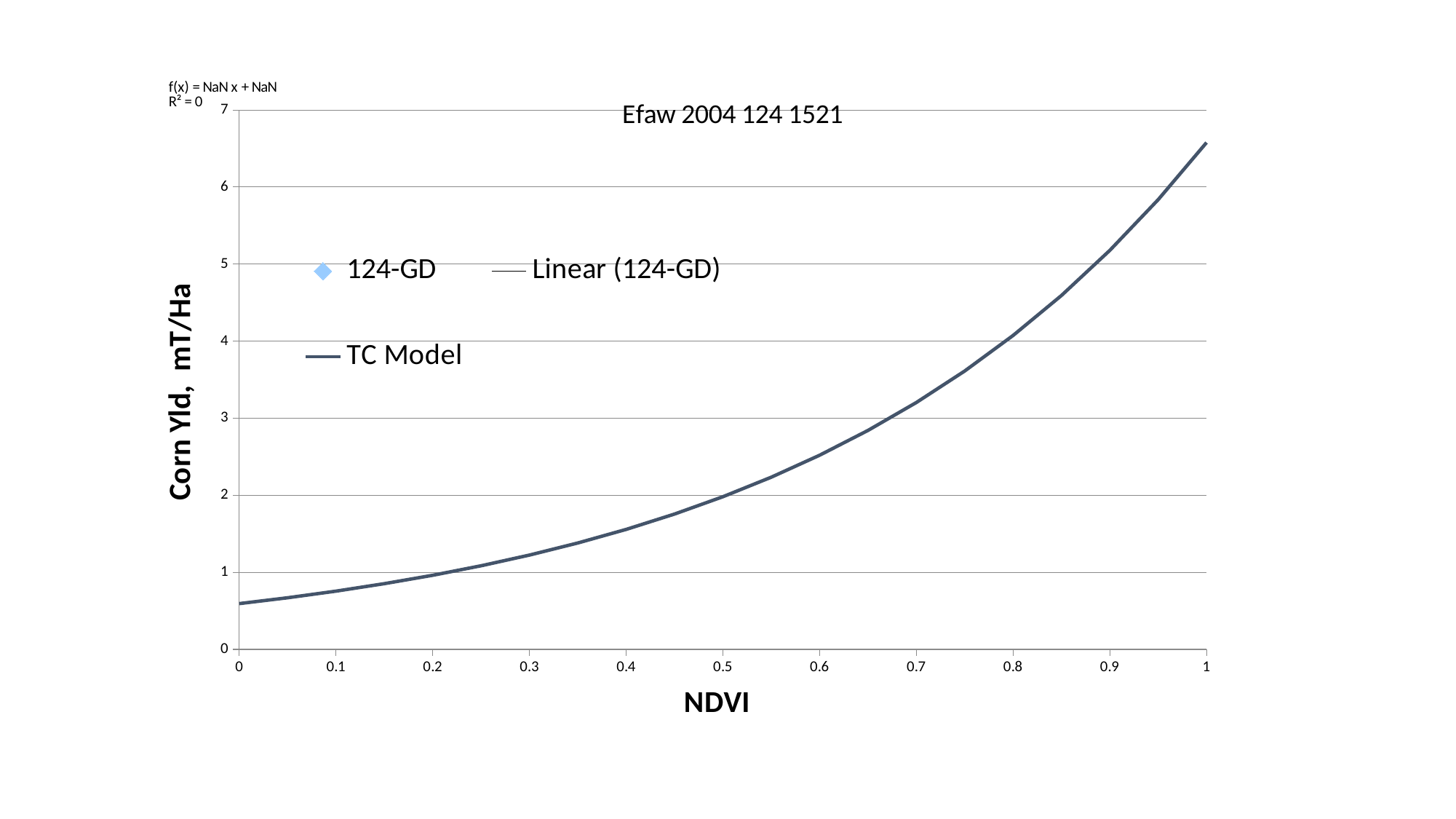
Is the TC Model value at NDVI 0.9 greater or less than 6? less What kind of chart is shown on the slide? line chart Is the TC Model value at NDVI 0.6 greater or less than 3? less Is the TC Model value at NDVI 0.3 greater or less than 1? greater What is the label of the x axis? NDVI How many entries does the chart legend list? 3 Does the TC Model curve rise or fall as NDVI increases from 0 to 1? rise Which is larger for the TC Model curve: the value at NDVI 0.2 or the value at NDVI 0.8? NDVI 0.8 What is the title of the chart? Efaw 2004 124 1521